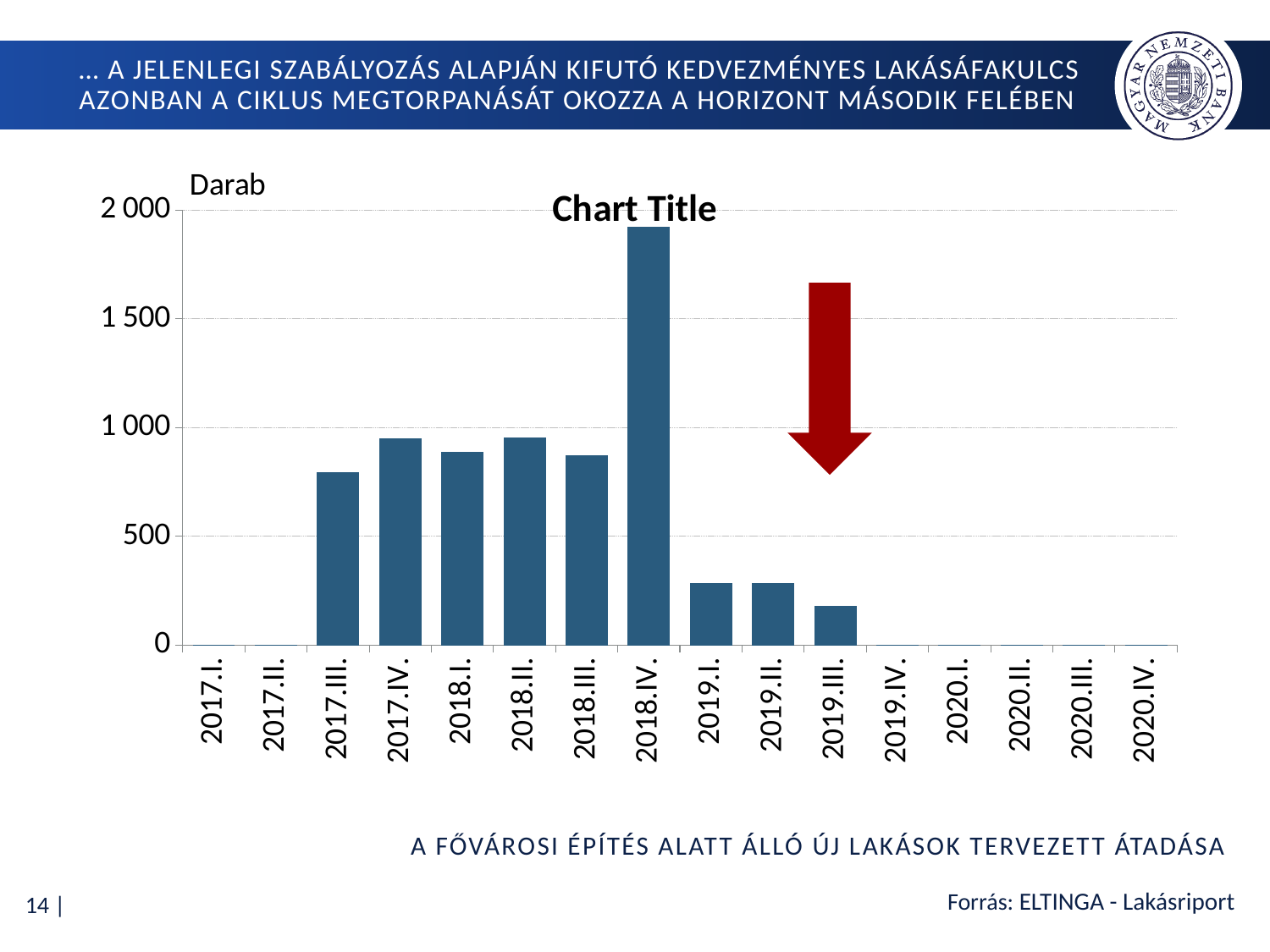
Do the values rise or fall from 2018.IV. to 2019.III.? fall Which quarter has the highest bar in the chart? 2018.IV. Is the value for 2018.IV. greater or less than 1 500? greater Which is larger, the value for 2019.III. or the value for 2018.II.? 2018.II. Is the value for 2019.III. greater or less than 500? less What kind of chart is shown on the slide? bar chart Which is larger, the value for 2018.IV. or the value for 2017.III.? 2018.IV. How many quarters are shown on the x axis of the chart? 16 Is the value for 2017.IV. greater or less than 1 000? less What unit label is shown above the y axis of the chart? Darab